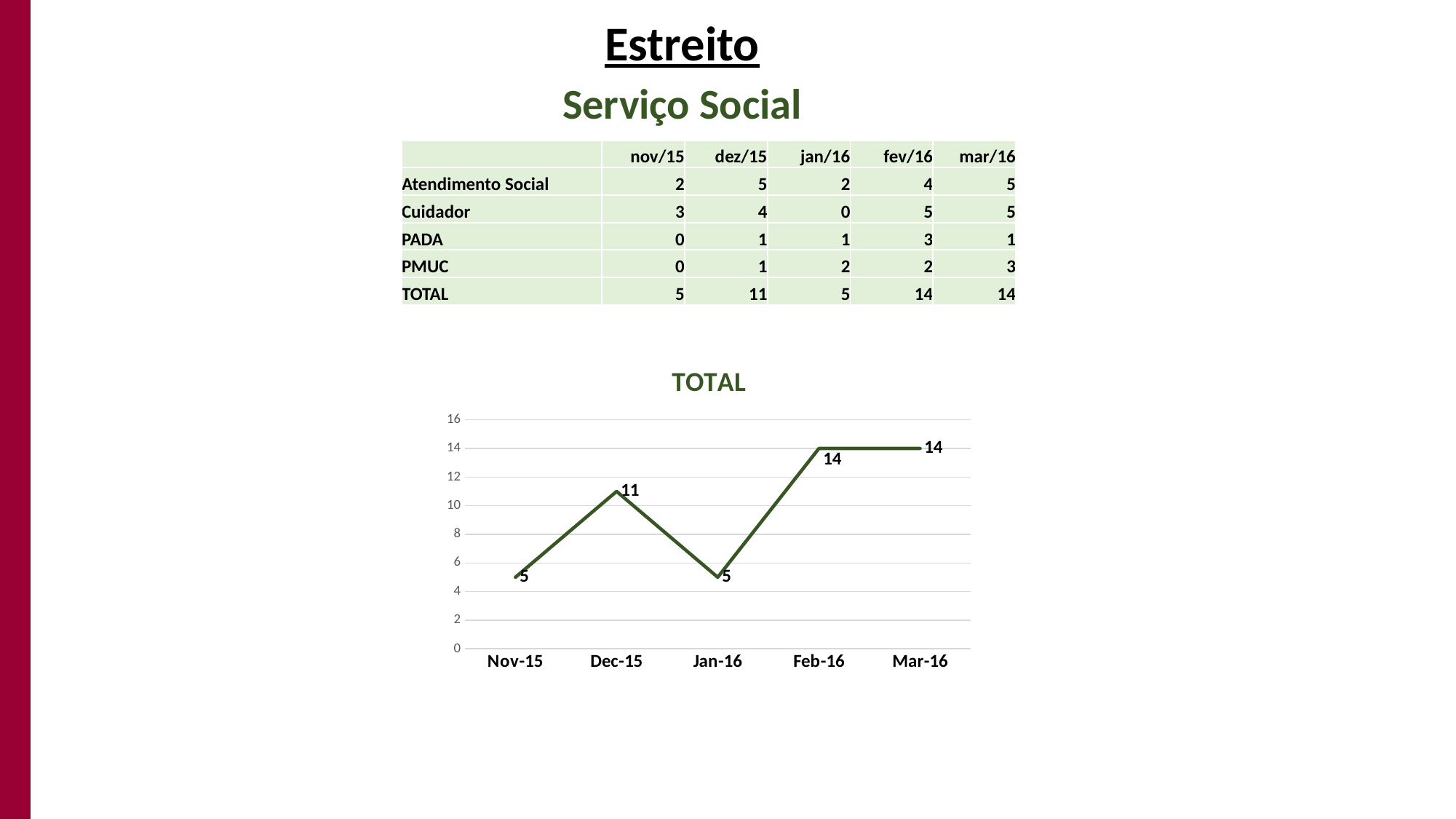
What is the difference between the values for Dec-15 and Nov-15 in the TOTAL chart? 6 What is the title of the chart on the slide? TOTAL Is the value for Dec-15 in the TOTAL chart greater or less than 10? greater What kind of chart is the TOTAL chart? line chart Does the value in the TOTAL chart rise or fall from Jan-16 to Feb-16? rise Which month has the lowest value in the TOTAL chart? Nov-15 and Jan-16 What is the value for Jan-16 in the TOTAL chart? 5 How many data points are plotted in the TOTAL chart? 5 Which is larger in the TOTAL chart, the value for Dec-15 or the value for Jan-16? Dec-15 What is the difference between the values for Feb-16 and Jan-16 in the TOTAL chart? 9 What is the value for Feb-16 in the TOTAL chart? 14 What is the value for Dec-15 in the TOTAL chart? 11